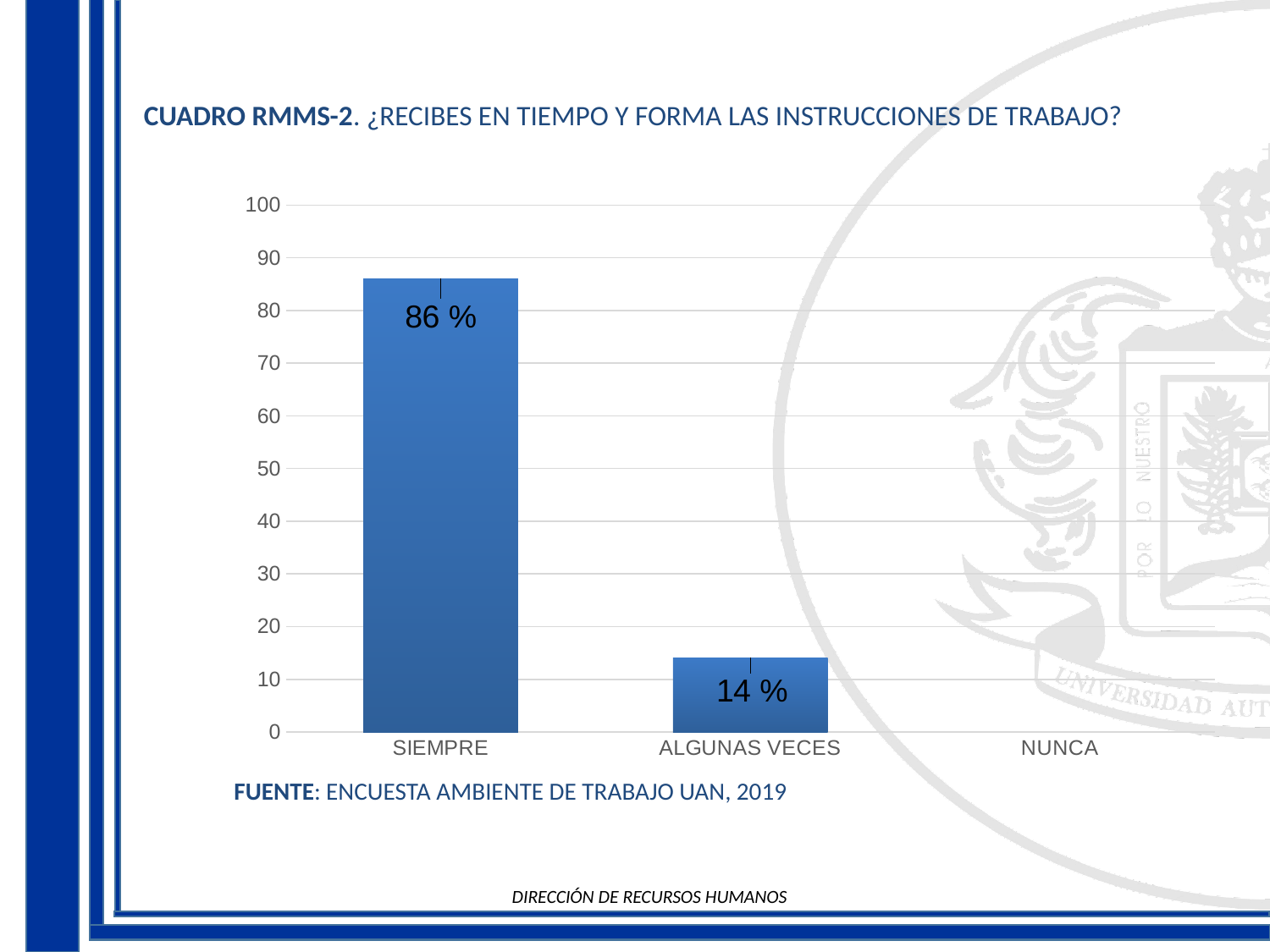
What is the value for ALGUNAS VECES? 14 % What is the value for SIEMPRE? 86 % What is the title of the chart? CUADRO RMMS-2. ¿RECIBES EN TIEMPO Y FORMA LAS INSTRUCCIONES DE TRABAJO? Is the value for SIEMPRE greater or less than 80? greater What is the maximum value shown on the y axis? 100 Which is larger, the value for SIEMPRE or the value for ALGUNAS VECES? SIEMPRE What kind of chart is shown on the slide? Bar chart How many categories are shown on the x axis? 3 What is the difference between the values for SIEMPRE and ALGUNAS VECES? 72 % Do the values rise or fall from SIEMPRE to ALGUNAS VECES? Fall Is the value for ALGUNAS VECES greater or less than 20? less Which category has the highest value? SIEMPRE